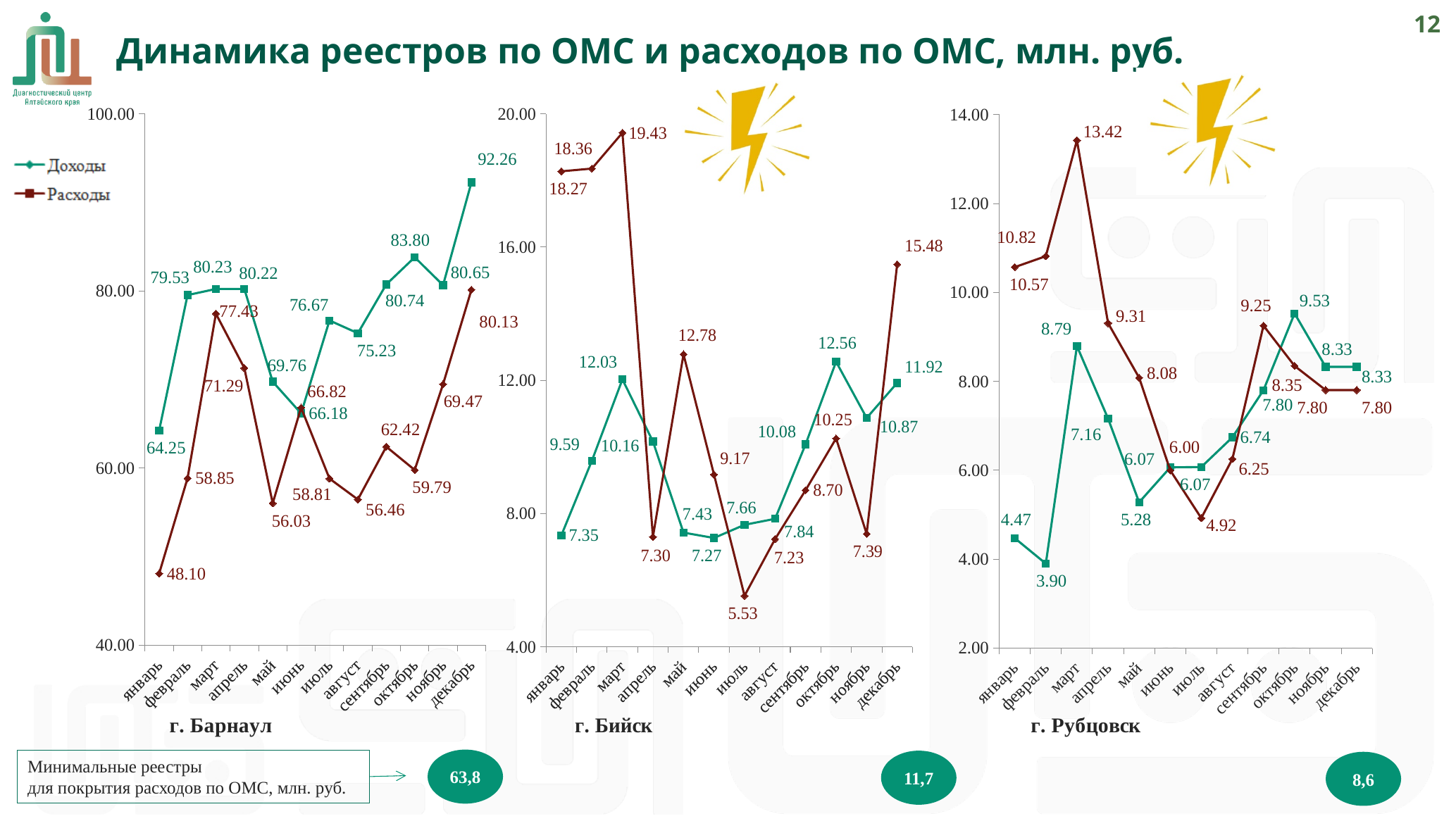
On the г. Рубцовск chart, what is the Расходы value for март? 13.42 What type of chart is used for г. Бийск? Line chart On the г. Барнаул chart, what is the Доходы value for декабрь? 92.26 On the г. Рубцовск chart, in which month is Доходы lowest? февраль On the г. Барнаул chart, what is the Расходы value for январь? 48.10 On the г. Барнаул chart, what is the difference between Доходы and Расходы in декабрь? 12.13 How many months are plotted on the г. Рубцовск chart? 12 How many series does the legend list for the charts? 2 On the г. Бийск chart, in which month is Расходы lowest? июль What are the two series names shown in the legend? Доходы and Расходы On the г. Бийск chart, in which month is Расходы highest? март On the г. Бийск chart, which series has the larger value in январь, Доходы or Расходы? Расходы